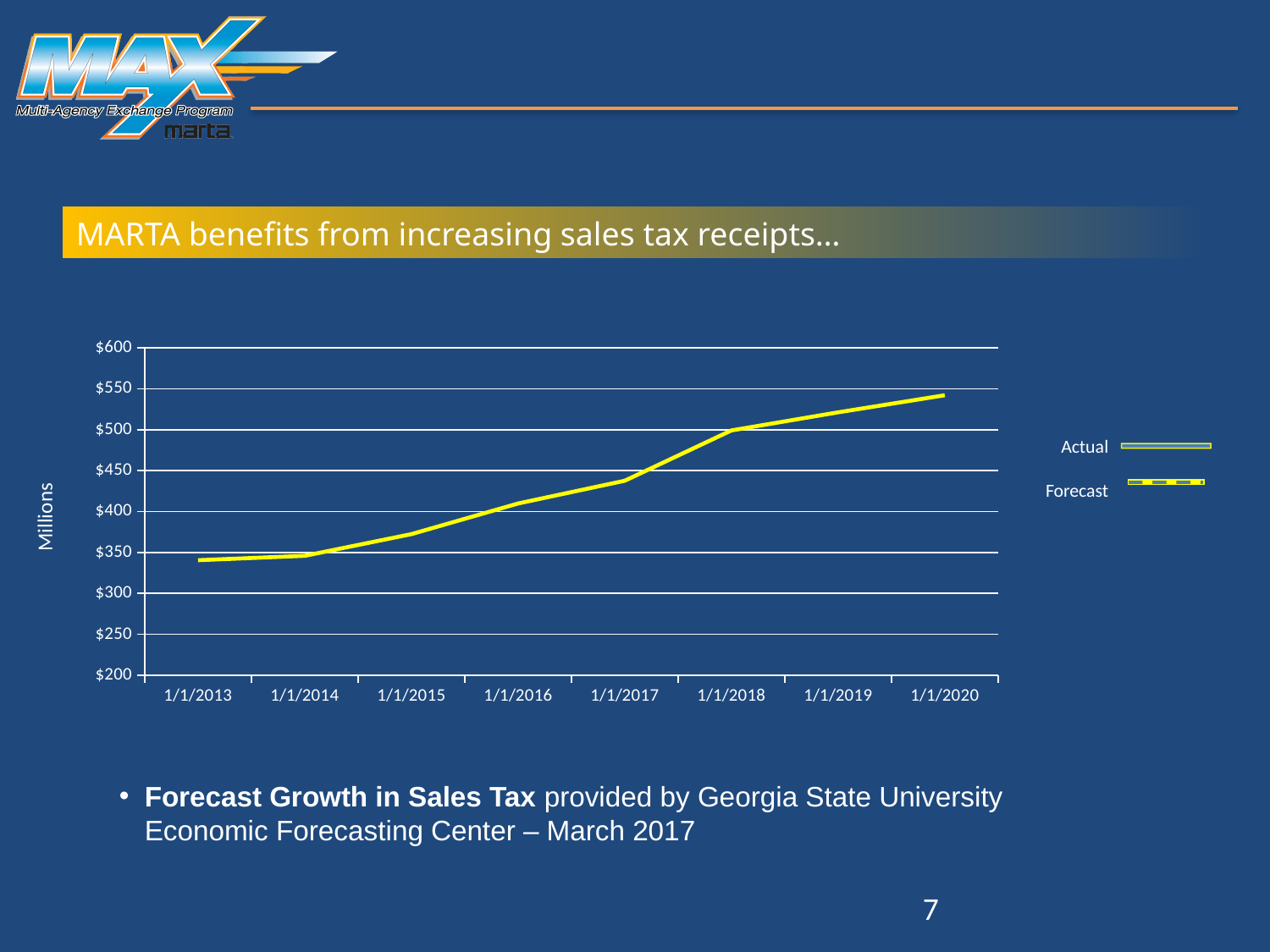
What kind of chart is shown on the slide? line chart What is the label on the vertical axis of the chart? Millions Which is larger, the value for 1/1/2018 or the value for 1/1/2015? 1/1/2018 Do the values rise or fall from 1/1/2013 to 1/1/2020? rise Is the value for 1/1/2015 greater or less than $350? greater What are the two entries in the chart's legend? Actual and Forecast At which date does the line reach its highest value? 1/1/2020 How many series does the legend list? 2 Is the value for 1/1/2017 greater or less than $450? less Is the value for 1/1/2013 greater or less than $350? less How many dates are marked along the x axis of the chart? 8